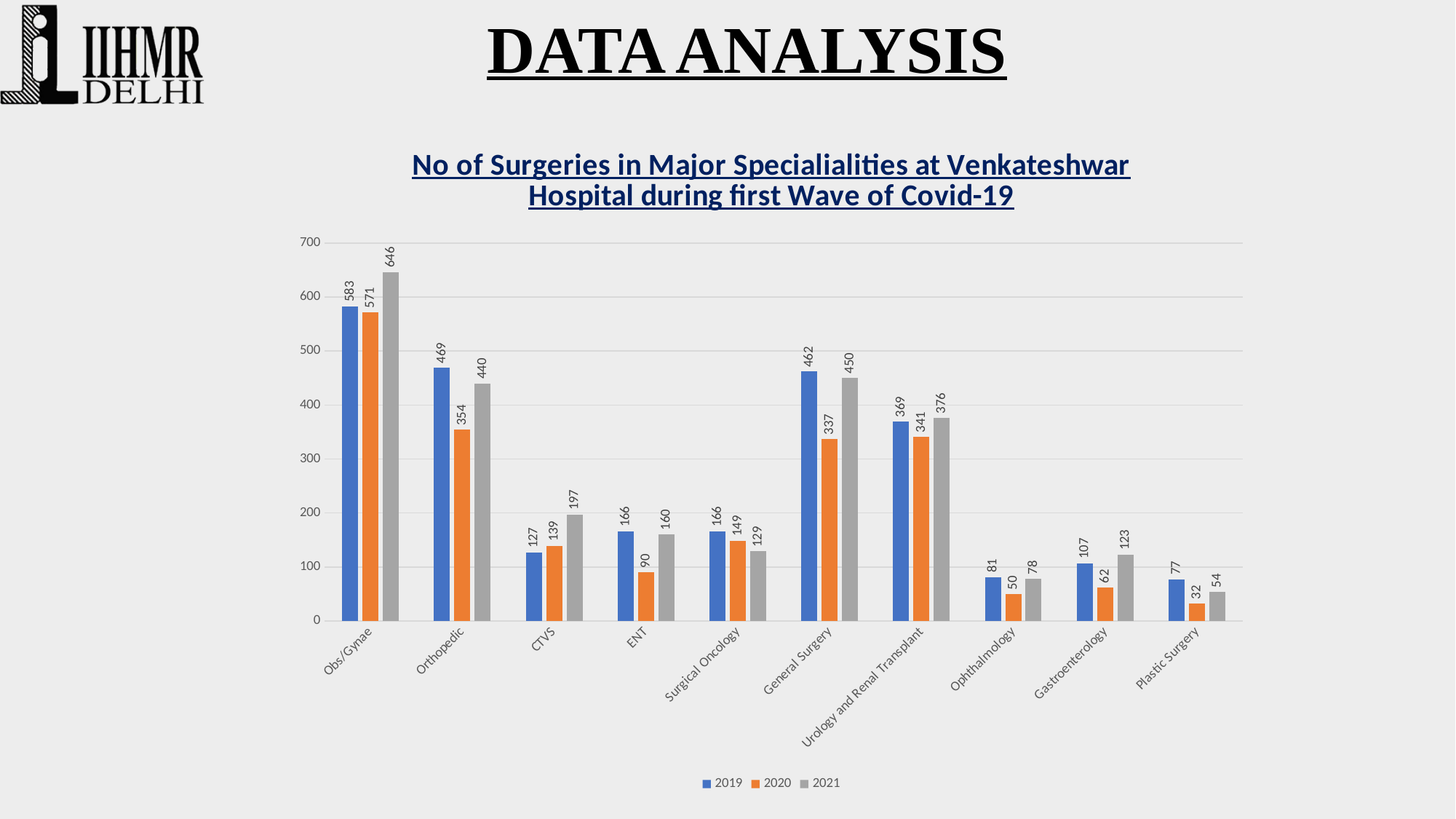
Which specialty has the lowest number of surgeries in 2021? Plastic Surgery Which colour represents the 2020 series in the legend? Orange Which specialty has the highest number of surgeries in 2020? Obs/Gynae What is the number of surgeries for Urology and Renal Transplant in 2019? 369 What is the number of surgeries for ENT in 2020? 90 What is the number of surgeries for Obs/Gynae in 2021? 646 What is the difference between the 2021 and 2020 values for Gastroenterology? 61 How many specialties are shown on the x axis? 10 What is the difference between the 2019 and 2020 values for Orthopedic? 115 What kind of chart is shown on the slide? Bar chart How many series does the legend list? 3 Which is larger for General Surgery: the 2019 value or the 2021 value? 2019